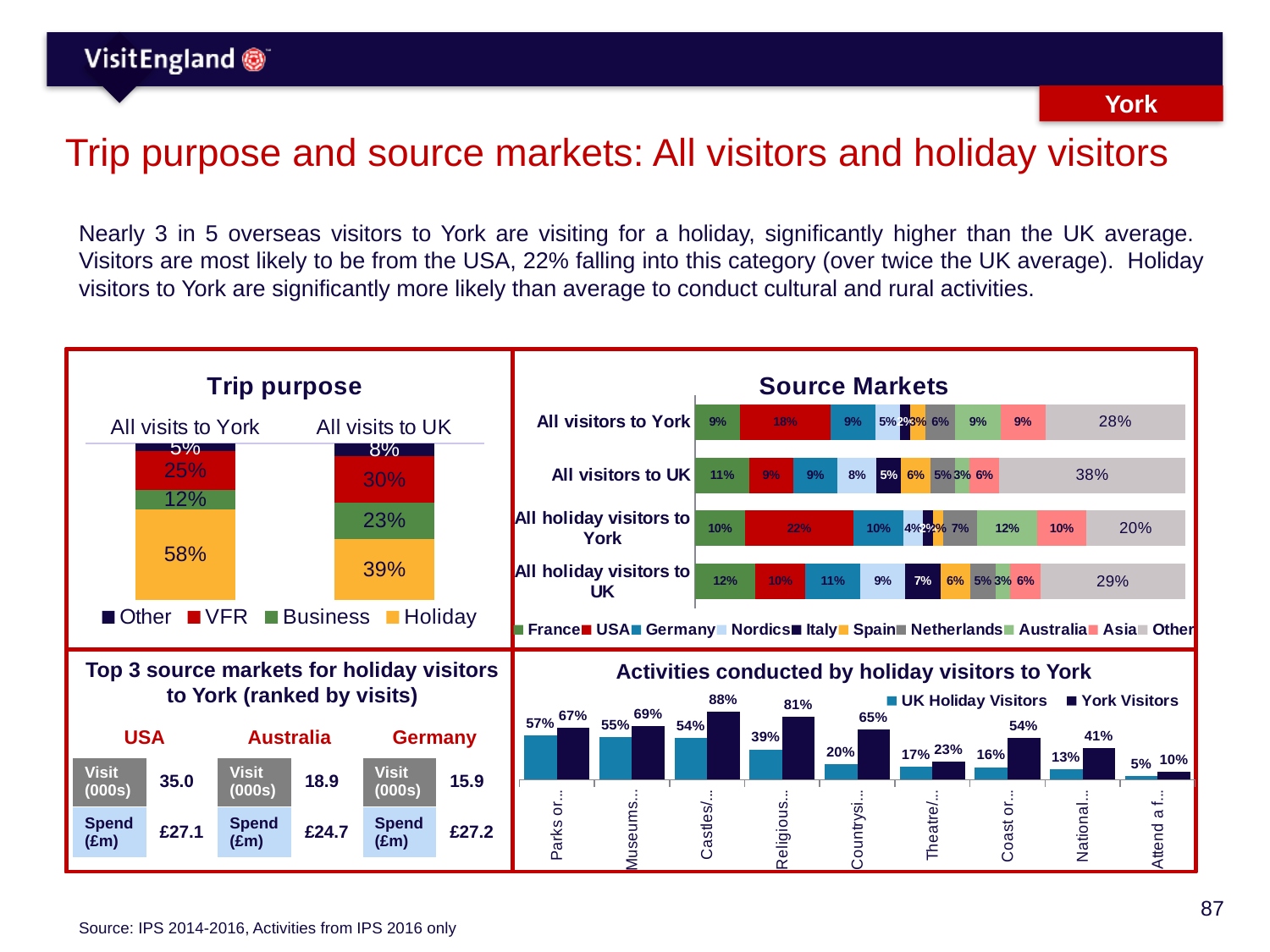
In the Activities conducted by holiday visitors to York chart, which activity has the highest value for York Visitors? Castles What kind of chart is the Activities conducted by holiday visitors to York chart? Bar chart In the Source Markets chart, how many source market series does the legend list? 10 In the Source Markets chart, what is the Other share for all visitors to UK? 38% In the Activities conducted by holiday visitors to York chart, what percentage of York Visitors visited Castles? 88% In the Trip purpose chart, what percentage of all visits to York are for Holiday? 58% In the Activities conducted by holiday visitors to York chart, what is the difference between York Visitors and UK Holiday Visitors for Religious activities? 42 percentage points In the Trip purpose chart, what percentage of all visits to UK are for Business? 23% In the Source Markets chart, what percentage of all holiday visitors to York come from the USA? 22% In the Trip purpose chart, how many series does the legend list? 4 In the Trip purpose chart, what is the difference between the Holiday share for all visits to York and for all visits to UK? 19 percentage points In the Source Markets chart, which is larger: the USA share for all visitors to York or the USA share for all visitors to UK? All visitors to York